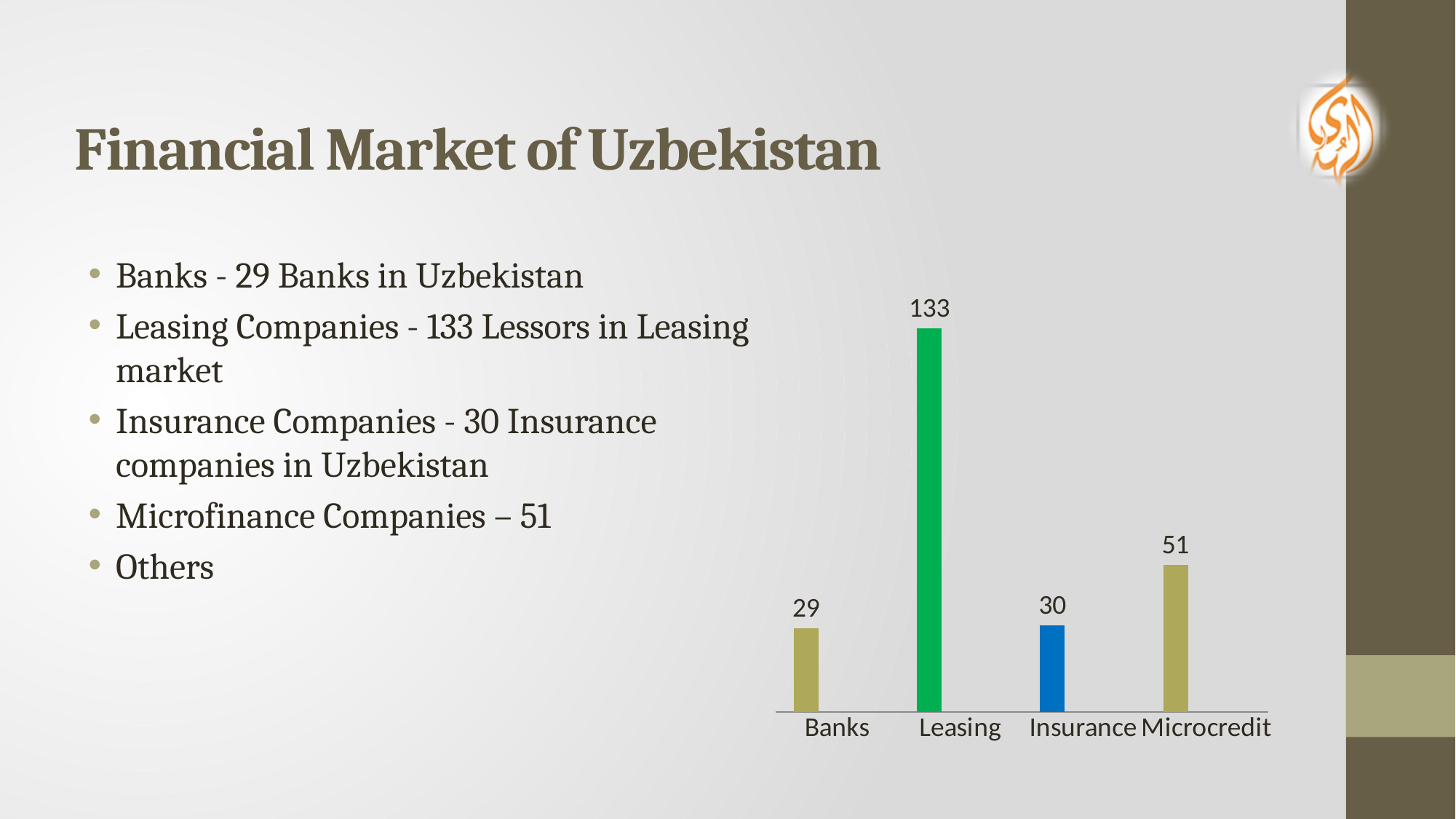
Which category has the lowest value in the chart? Banks What is the value for Microcredit in the chart? 51 Which is larger, the value for Microcredit or the value for Insurance? Microcredit What is the difference between the values for Insurance and Banks? 1 How many categories are shown in the chart? 4 What kind of chart is shown on the slide? Bar chart What is the value for Insurance in the chart? 30 Which category has the highest value in the chart? Leasing What is the value for Banks in the chart? 29 What colour is the Leasing bar in the chart? Green What is the difference between the values for Leasing and Microcredit? 82 What is the value for Leasing in the chart? 133